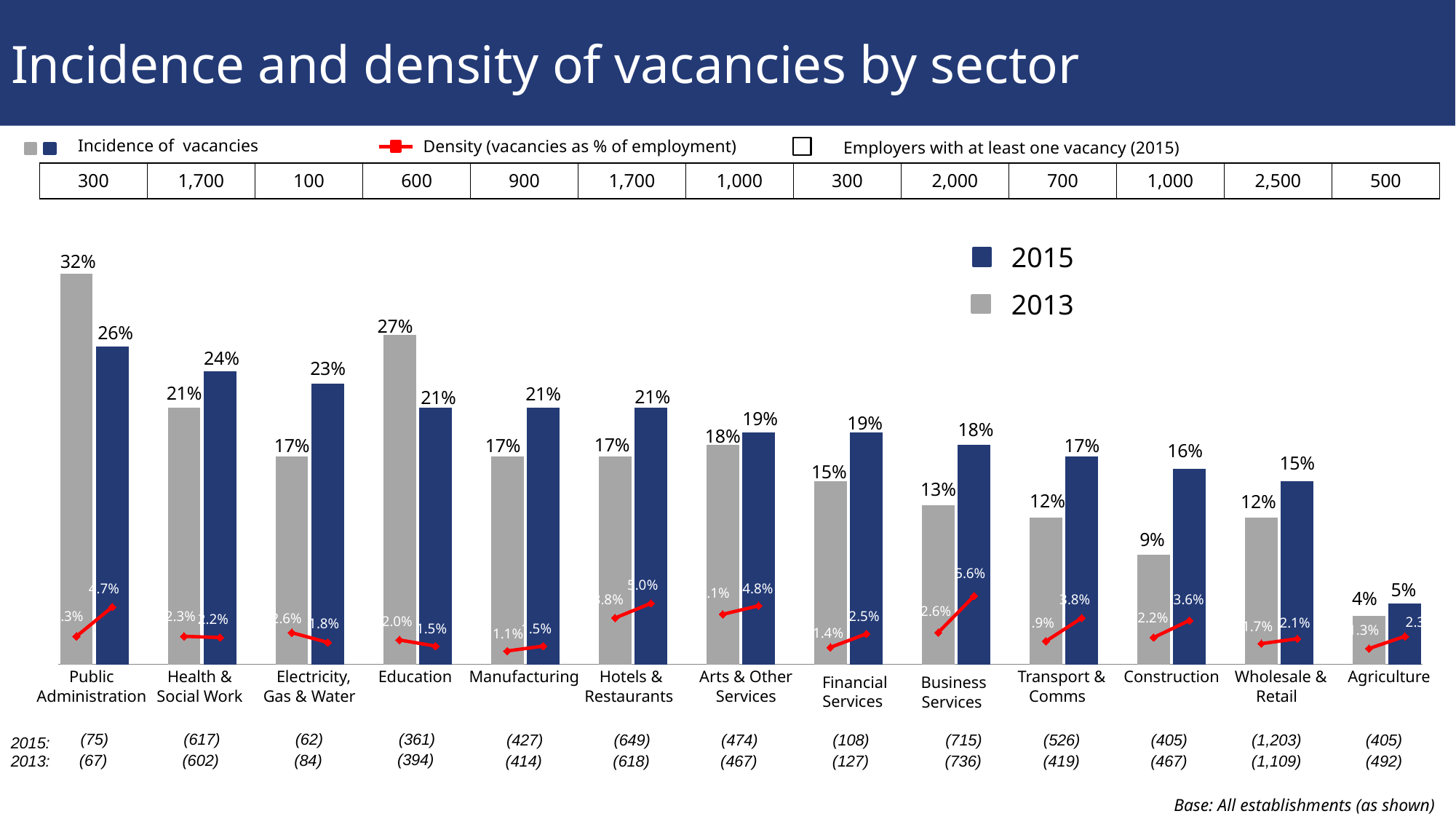
What is the 2015 density of vacancies (as % of employment) for Business Services? 5.6% What is the 2015 density of vacancies for Hotels & Restaurants? 5.0% Which sector has the highest 2013 incidence of vacancies? Public Administration Which is larger for Business Services: the 2015 or the 2013 incidence of vacancies? 2015 How many series does the legend list? 2 What is the difference between the 2013 and 2015 incidence of vacancies for Construction? 7% What is the 2013 incidence of vacancies for Education? 27% What kind of chart is used to show the incidence of vacancies? Bar chart How many sectors are shown on the chart? 13 Which colour represents 2013 in the chart? Grey What is the 2015 incidence of vacancies for Public Administration? 26% Which sector has the lowest 2015 incidence of vacancies? Agriculture